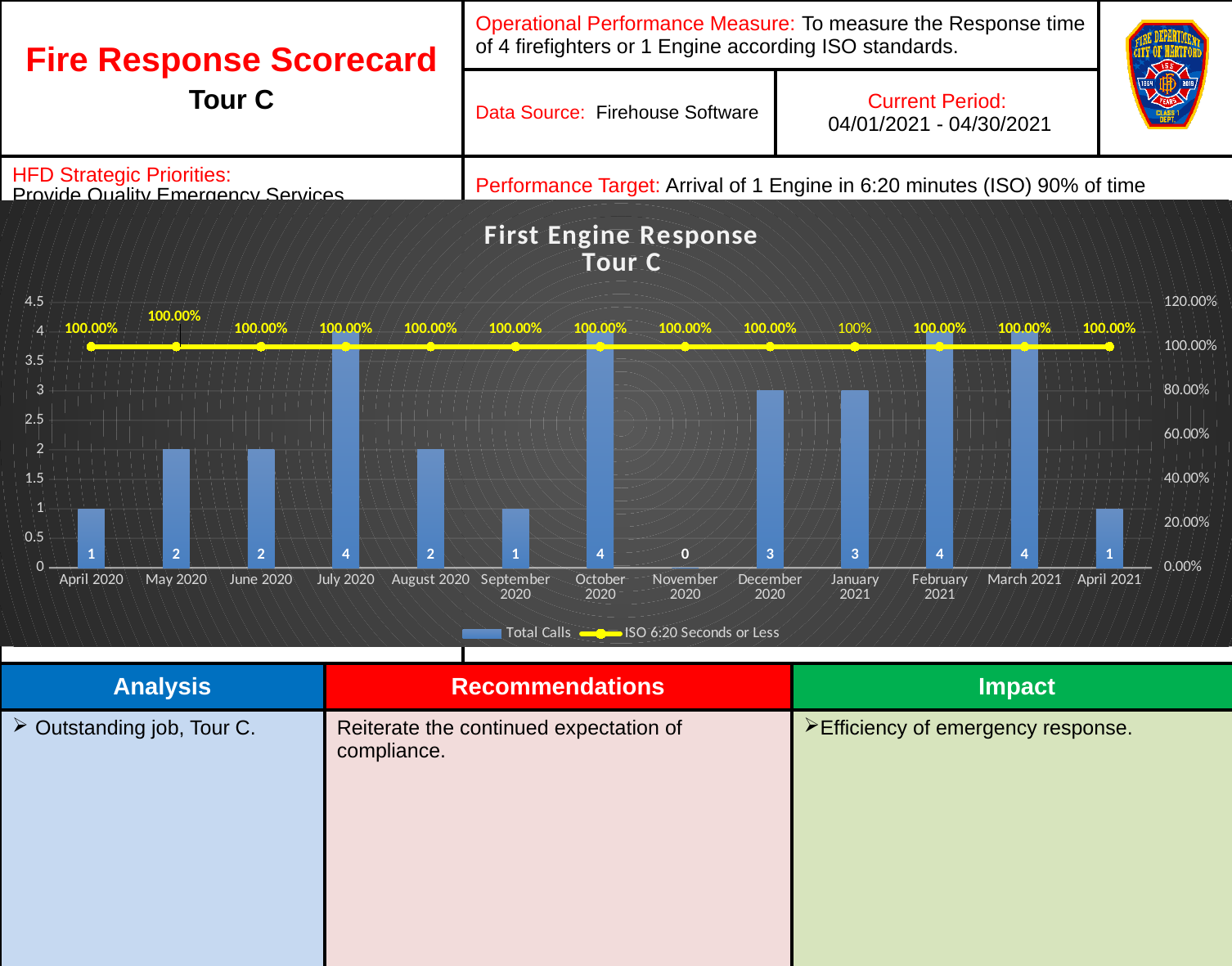
Which has more Total Calls, May 2020 or January 2021? January 2021 What is the Total Calls value for November 2020? 0 How many series does the chart legend list? 2 What is the difference in Total Calls between March 2021 and April 2021? 3 What is the Total Calls value for December 2020? 3 Which month has the lowest Total Calls value? November 2020 What is the ISO 6:20 Seconds or Less value for October 2020? 100.00% What is the title of the chart? First Engine Response Tour C Does the ISO 6:20 Seconds or Less line rise, fall, or stay flat across the months? Stays flat What kind of chart is used to show Total Calls? Bar chart How many months are shown on the x axis of the chart? 13 What is the Total Calls value for July 2020? 4